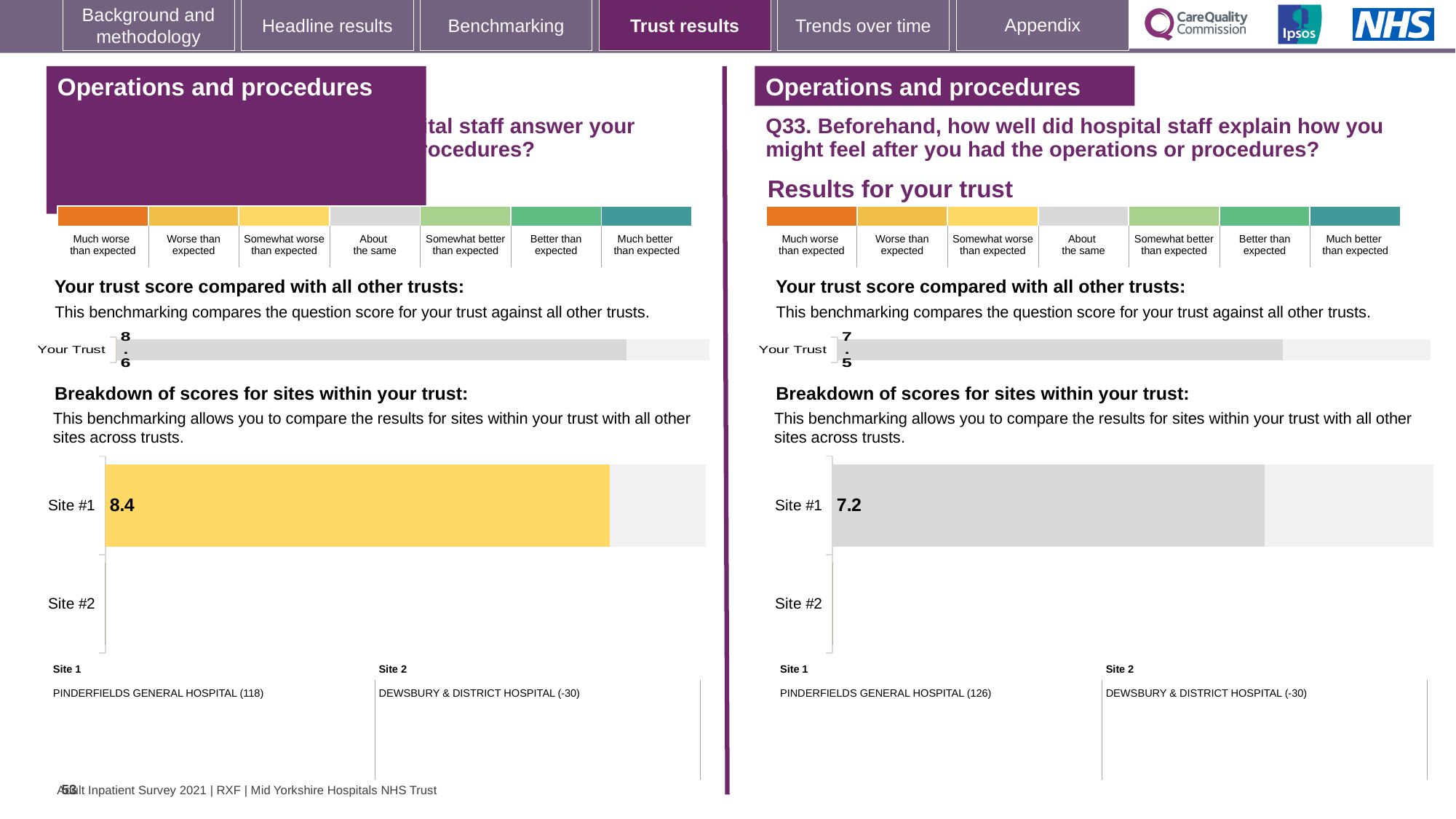
On the left-hand breakdown chart, what colour is the Site #1 bar? Yellow How many sites are listed on the left-hand 'Breakdown of scores for sites within your trust' chart? 2 On the left-hand 'Your trust score compared with all other trusts' chart, what is the score shown for 'Your Trust'? 8.6 What type of chart is used for the 'Breakdown of scores for sites within your trust' on the right-hand side? Bar chart On the right-hand side of the slide for Q33, what is the difference between the 'Your Trust' score and the Site #1 score? 0.3 Which is larger: the 'Your Trust' score on the left-hand chart or the 'Your Trust' score on the right-hand chart for Q33? Left-hand chart (8.6) On the right-hand chart for Q33, what is the score shown for 'Your Trust'? 7.5 On the left-hand 'Breakdown of scores for sites within your trust' chart, what is the score for Site #1? 8.4 Which is larger: the Site #1 score on the left-hand breakdown chart or the Site #1 score on the right-hand breakdown chart for Q33? Left-hand chart (8.4) On the right-hand breakdown chart for Q33, what colour is the Site #1 bar? Grey On the left-hand side of the slide, what is the difference between the 'Your Trust' score and the Site #1 score? 0.2 On the right-hand 'Breakdown of scores for sites within your trust' chart for Q33, what is the score for Site #1? 7.2